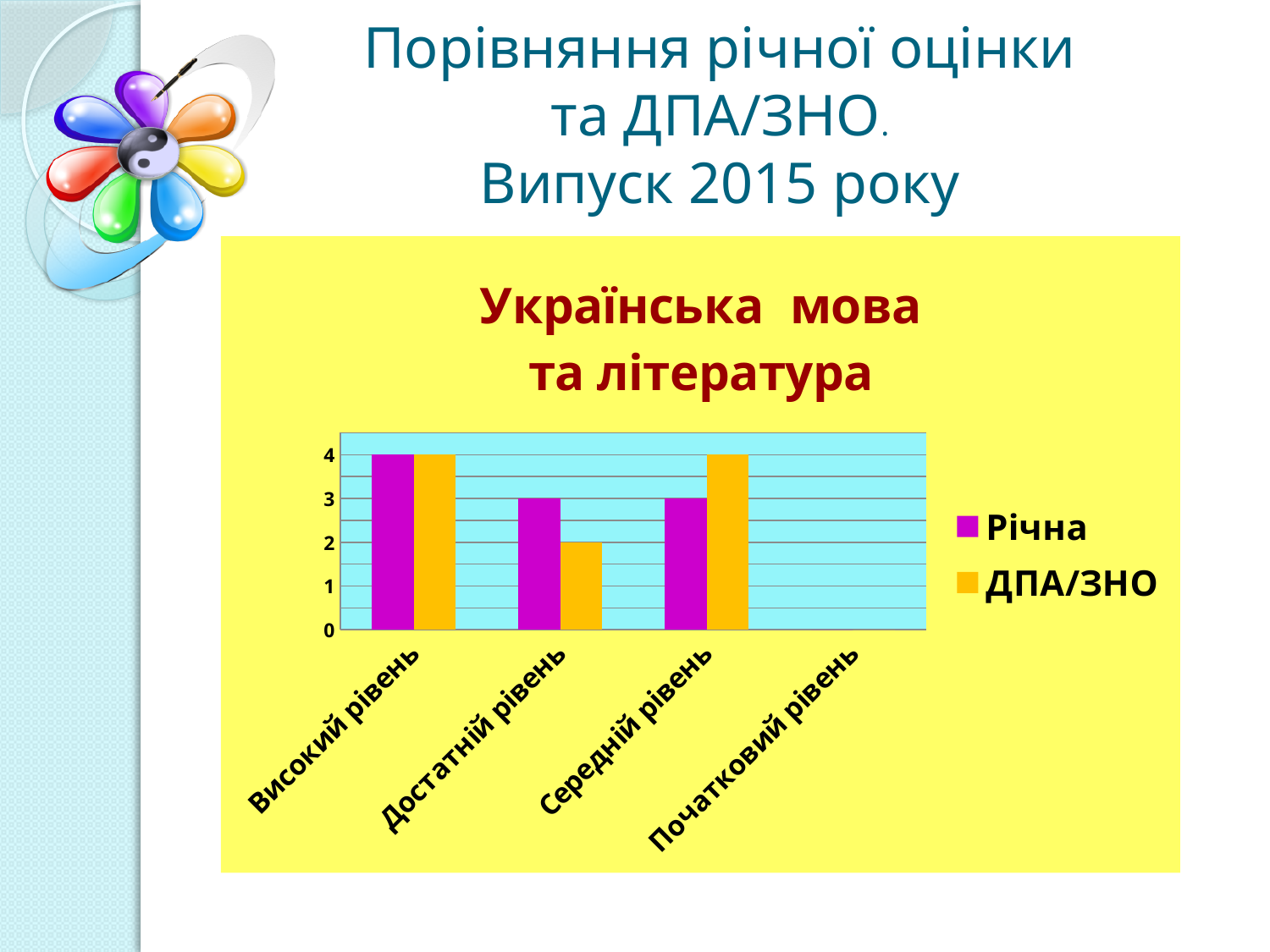
What is the value of Річна for Середній рівень? 3 Which category has the lowest ДПА/ЗНО value among those with visible bars? Достатній рівень How many series does the legend list? 2 What is the value of ДПА/ЗНО for Достатній рівень? 2 Which colour represents the ДПА/ЗНО series? orange What is the title of the chart? Українська мова та література What kind of chart is shown on the slide? bar chart How many categories are shown on the x axis? 4 What is the value of Річна for Високий рівень? 4 Which is larger for Достатній рівень, Річна or ДПА/ЗНО? Річна What is the difference between ДПА/ЗНО and Річна for Середній рівень? 1 What is the value of ДПА/ЗНО for Середній рівень? 4